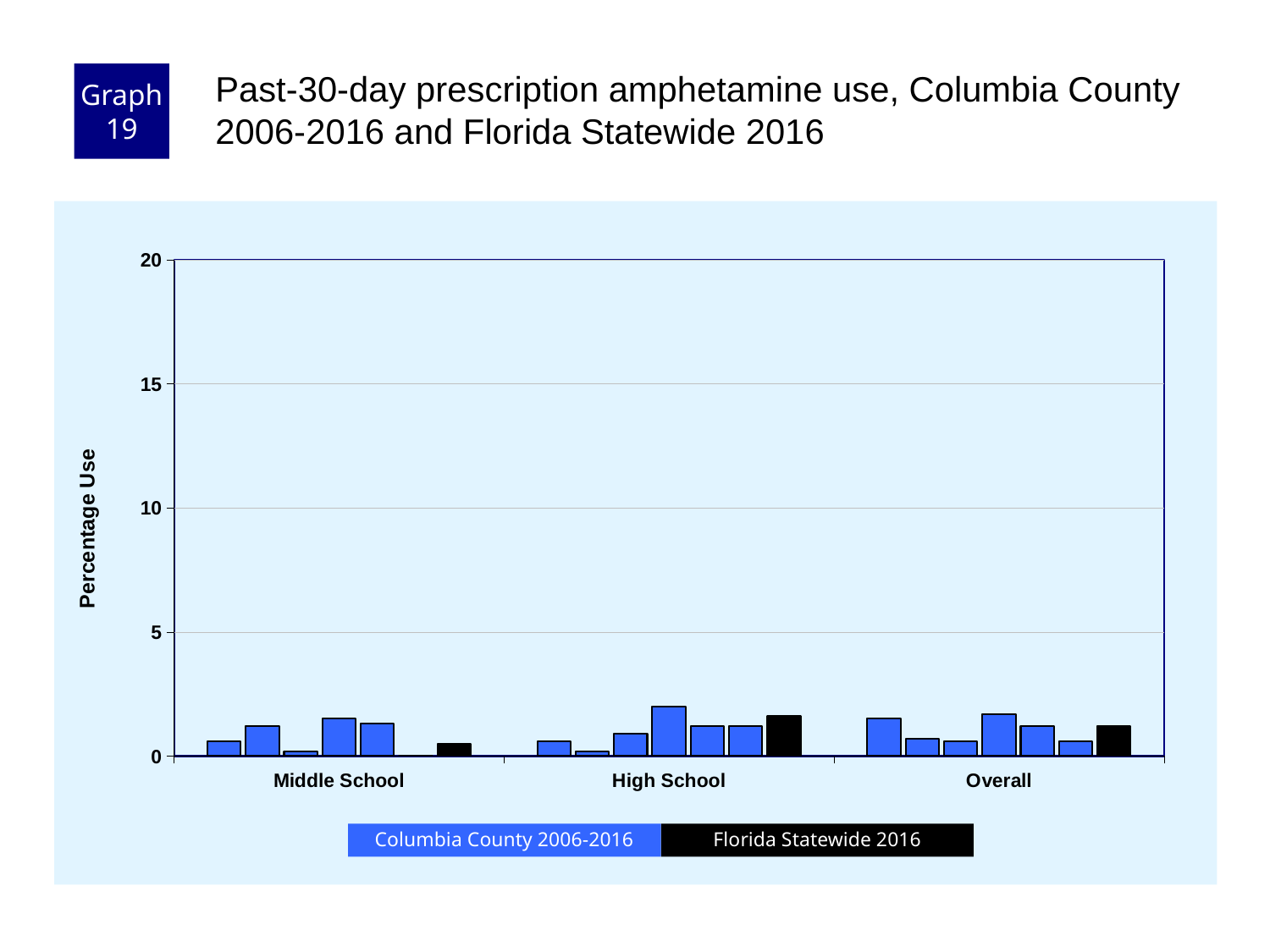
Which category has the highest Florida Statewide 2016 value? High School Is the Florida Statewide 2016 value larger for High School or for Middle School? High School How many categories are shown on the x axis? 3 Which category has the lowest Florida Statewide 2016 value? Middle School What is the label of the y axis? Percentage Use How many series does the legend list? 2 What kind of chart is shown on the slide? bar chart Which series is shown in black in the legend? Florida Statewide 2016 Is the Florida Statewide 2016 value larger for Overall or for Middle School? Overall Is the Florida Statewide 2016 value for Overall greater or less than 5? less Is the Florida Statewide 2016 value for High School greater or less than 5? less Is the Florida Statewide 2016 value for Middle School greater or less than 5? less